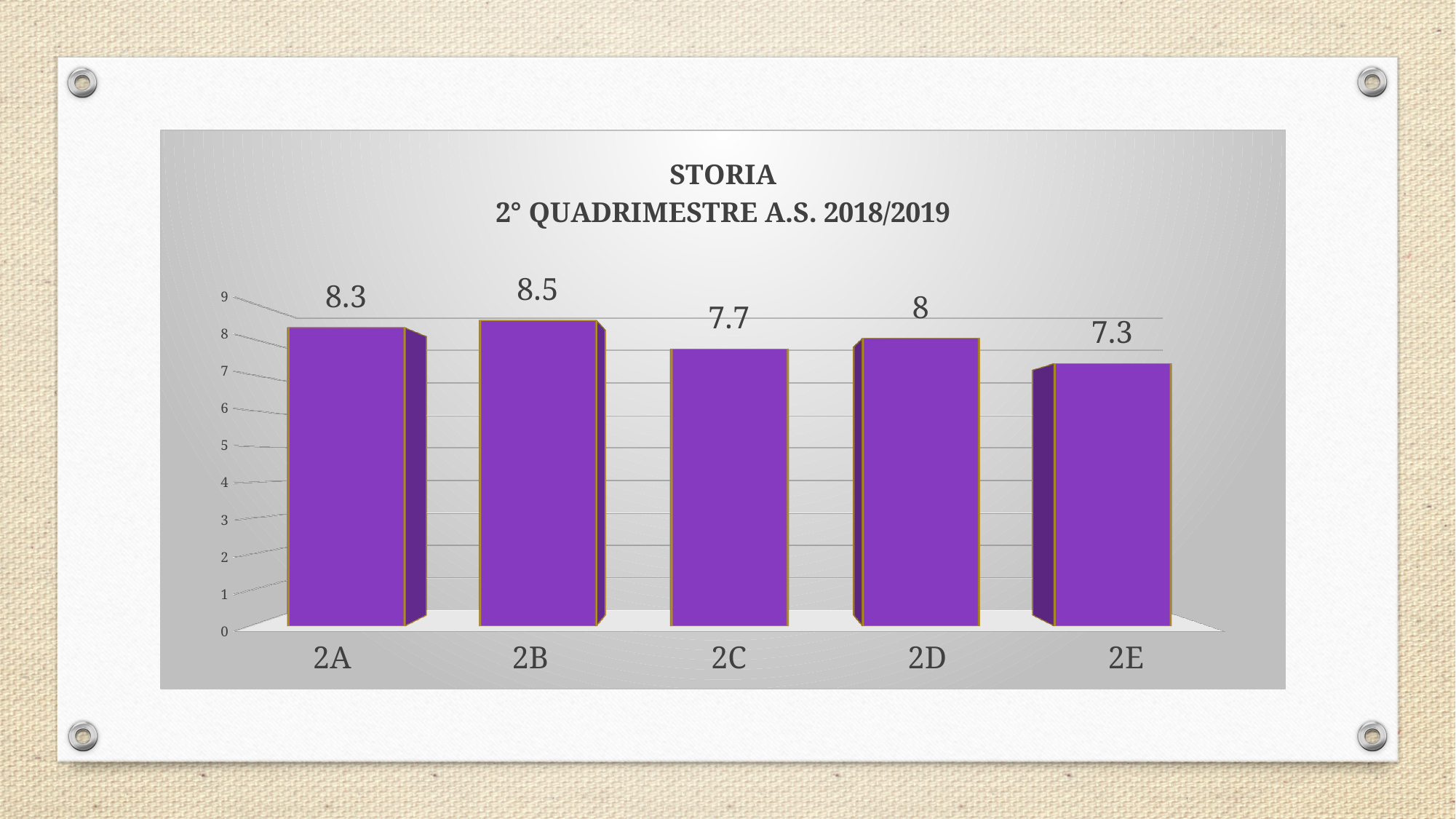
What is the value for 2A? 8.3 What is the value for 2C? 7.7 How many classes are shown on the chart? 5 Which class has the highest value? 2B What kind of chart is shown? bar chart What is the title of the chart? STORIA 2° QUADRIMESTRE A.S. 2018/2019 Which class has the lowest value? 2E What is the difference between the values for 2A and 2D? 0.3 What is the difference between the values for 2B and 2E? 1.2 Which is larger, the value for 2C or the value for 2D? 2D Is the value for 2B greater or less than 8? greater What is the value for 2E? 7.3